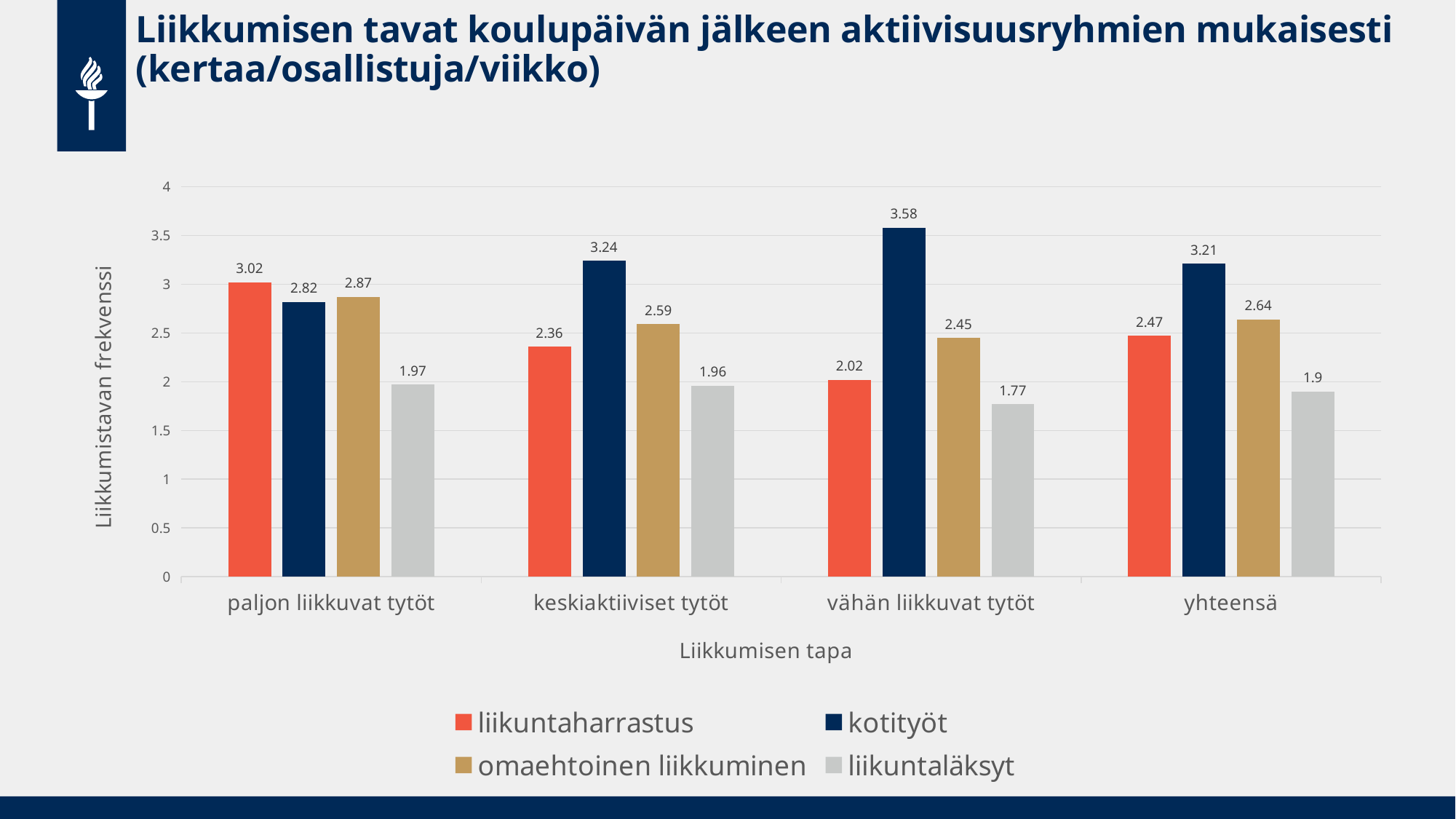
What is the value for liikuntaharrastus in the paljon liikkuvat tytöt group? 3.02 Is the value for liikuntaläksyt in the vähän liikkuvat tytöt group greater or less than 2? less How many groups are shown on the x axis? 4 What is the value for kotityöt in the vähän liikkuvat tytöt group? 3.58 In the paljon liikkuvat tytöt group, which is larger: liikuntaharrastus or kotityöt? liikuntaharrastus Which group has the highest value for kotityöt? vähän liikkuvat tytöt Which group has the lowest value for liikuntaharrastus? vähän liikkuvat tytöt What is the difference between the kotityöt and liikuntaharrastus values in the vähän liikkuvat tytöt group? 1.56 What is the value for liikuntaläksyt in the yhteensä group? 1.9 What is the value for omaehtoinen liikkuminen in the keskiaktiiviset tytöt group? 2.59 How many series does the legend list? 4 What kind of chart is shown on the slide? bar chart